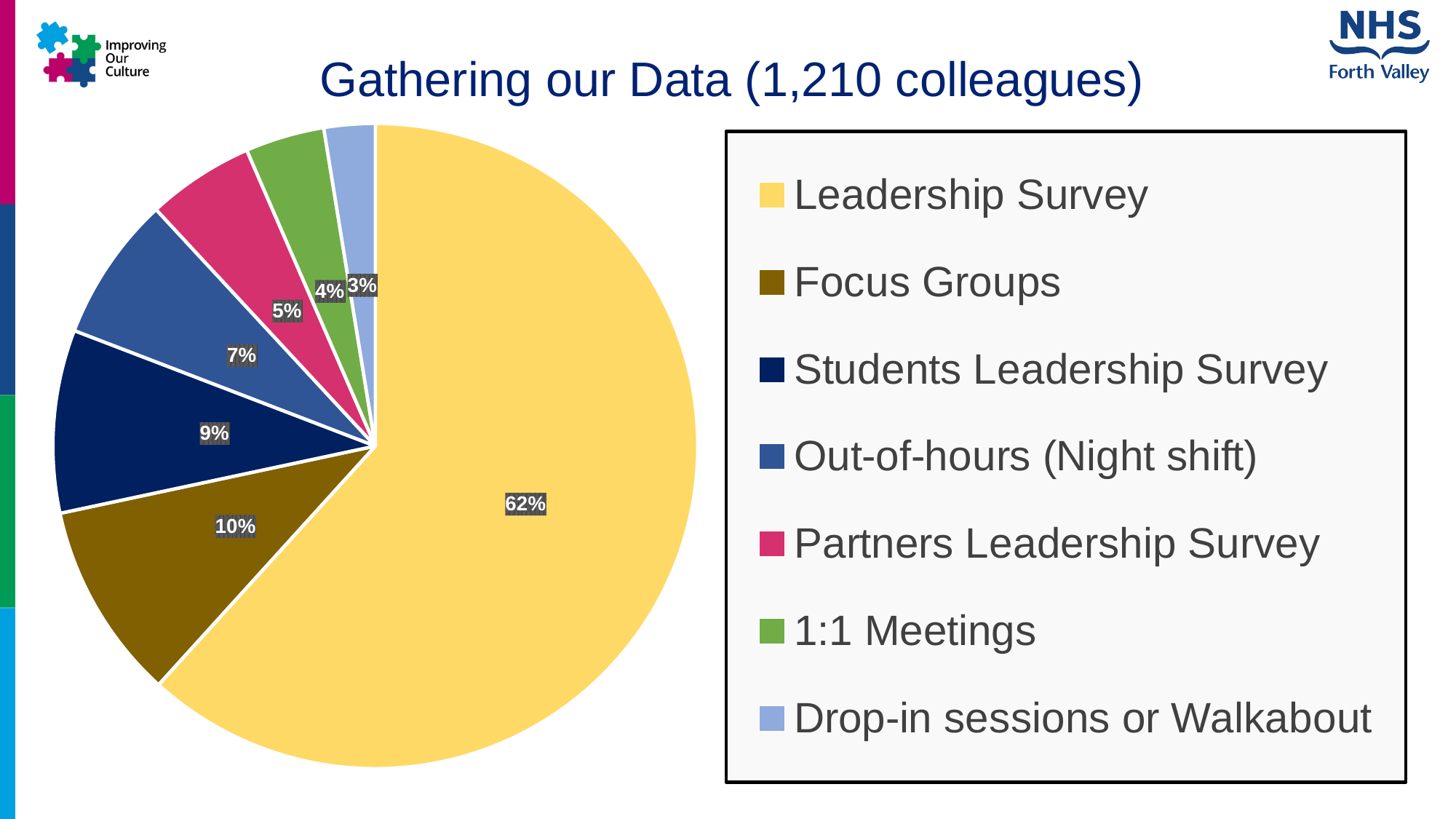
Which category has the largest slice of the pie? Leadership Survey What percentage is shown for Drop-in sessions or Walkabout? 3% What percentage is shown for Students Leadership Survey? 9% How many categories does the legend list? 7 What share of the pie does Leadership Survey account for? 62% What percentage is shown for Out-of-hours (Night shift)? 7% What is the difference in percentage points between Focus Groups and Partners Leadership Survey? 5 What kind of chart is shown on the slide? pie chart Which is larger, the slice for 1:1 Meetings or the slice for Out-of-hours (Night shift)? Out-of-hours (Night shift) What is the title of the chart slide? Gathering our Data (1,210 colleagues) What percentage is shown for Focus Groups? 10% Which category has the smallest slice of the pie? Drop-in sessions or Walkabout